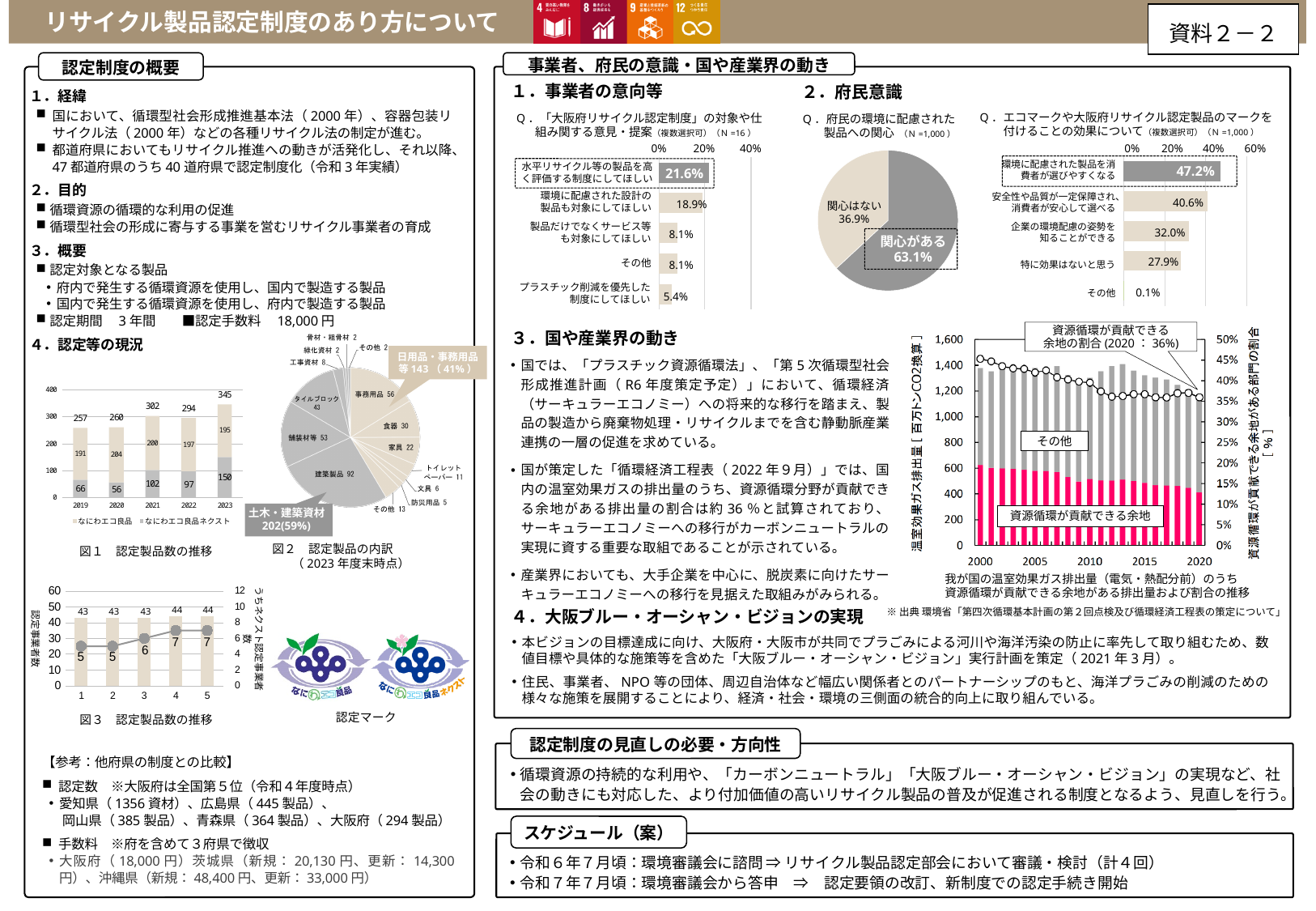
In the pie chart 図2 認定製品の内訳, which is larger, 舗装材等 or タイルブロック? 舗装材等 In the chart 図1 認定製品数の推移, what is the value for なにわエコ良品ネクスト in 2021? 102 In the chart 図1 認定製品数の推移, how many series does the legend list? 2 In the chart 図1 認定製品数の推移, which year has the lowest total? 2019 In the pie chart 図2 認定製品の内訳, what is the value for 建築製品? 92 What kind of chart is 図3 認定製品数の推移 at the bottom left? Combined bar and line chart In the pie chart under 2. 府民意識, what share of respondents answered 関心がある? 63.1% In the chart 図1 認定製品数の推移, what is the total number of certified products in 2023? 345 In the bar chart about the effect of エコマーク and 大阪府リサイクル認定製品のマーク, which category has the lowest value? その他 In the bar chart under 1. 事業者の意向等, what is the difference between the highest value and the value for プラスチック削減を優先した制度にしてほしい? 16.2% In the pie chart 図2 認定製品の内訳, what share does 土木・建築資材 account for? 59% In the bar chart under 1. 事業者の意向等, what is the value for 水平リサイクル等の製品を高く評価する制度にしてほしい? 21.6%